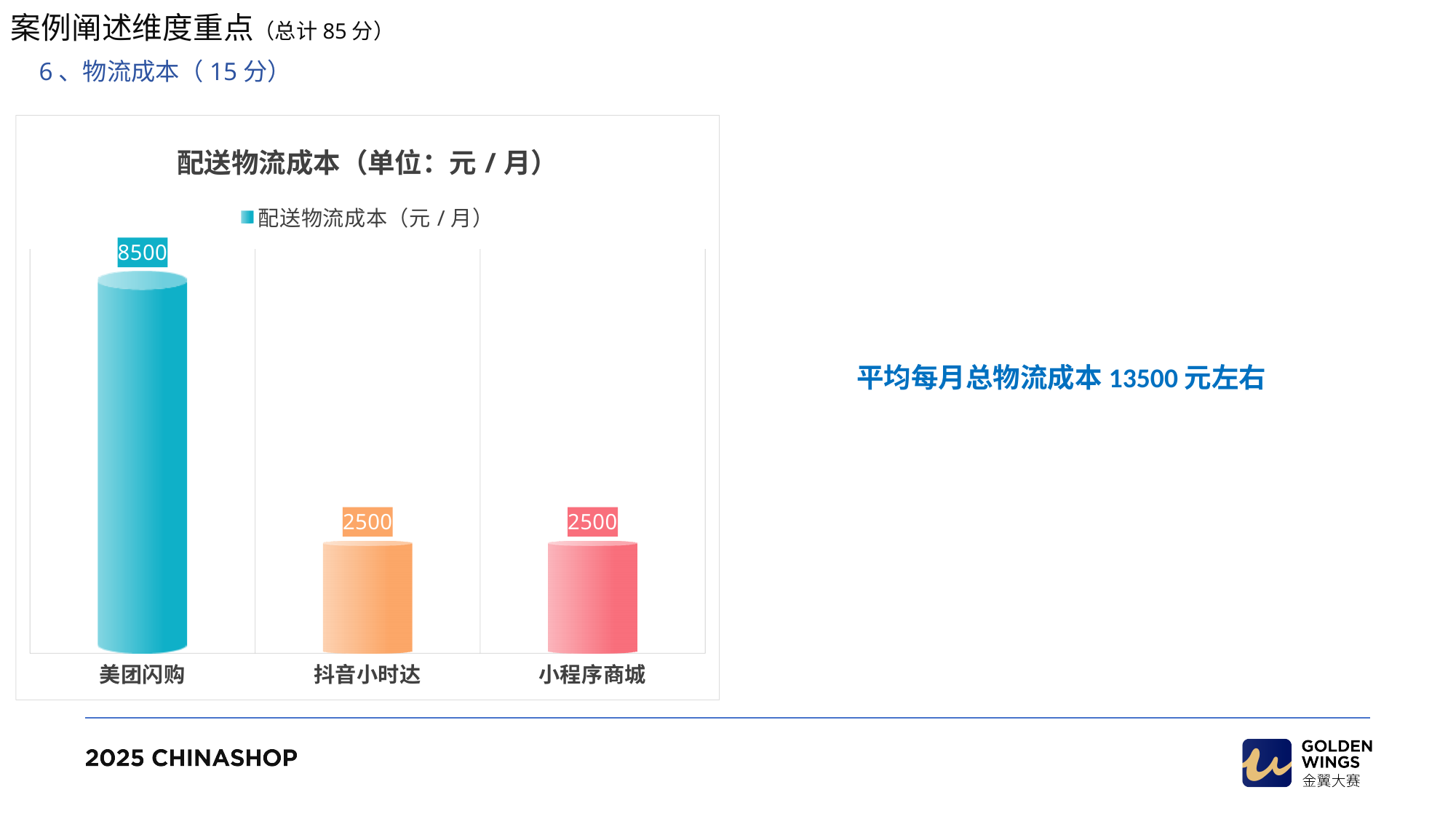
How many categories are shown in the chart? 3 What is the value for 美团闪购 in the chart? 8500 What is the total of the three values plotted in the chart? 13500 Which is larger, the value for 美团闪购 or the value for 小程序商城? 美团闪购 What is the legend entry shown in the chart? 配送物流成本（元 / 月） How many series does the legend list? 1 Which category has the highest value in the chart? 美团闪购 What is the difference between the values for 美团闪购 and 抖音小时达? 6000 What is the value for 小程序商城 in the chart? 2500 What is the value for 抖音小时达 in the chart? 2500 What is the title of the chart? 配送物流成本（单位：元 / 月） What kind of chart is shown on the slide? Bar chart